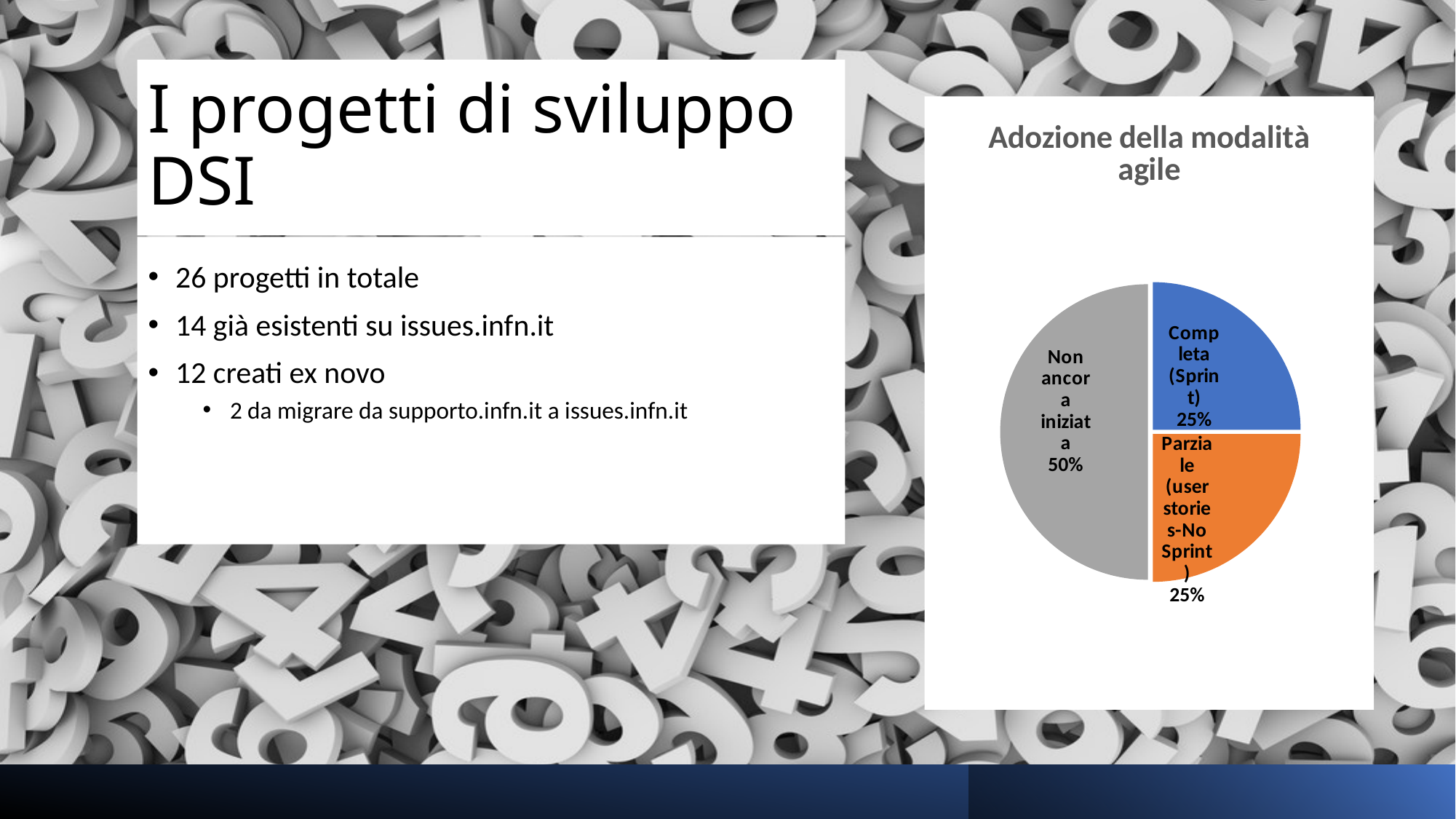
What kind of chart is shown on the slide? pie chart What is the difference between the share for 'Non ancora iniziata' and the share for 'Completa (Sprint)'? 25% What share of the pie is 'Completa (Sprint)'? 25% What is the title of the chart? Adozione della modalità agile How many slices does the pie chart have? 3 What colour is the 'Completa (Sprint)' slice? blue What share of the pie is 'Non ancora iniziata'? 50% Which slice of the pie is the largest? Non ancora iniziata What is the combined share of 'Completa (Sprint)' and 'Parziale (user stories-No Sprint)'? 50% What share of the pie is 'Parziale (user stories-No Sprint)'? 25% Which is larger: the share for 'Non ancora iniziata' or the share for 'Parziale (user stories-No Sprint)'? Non ancora iniziata